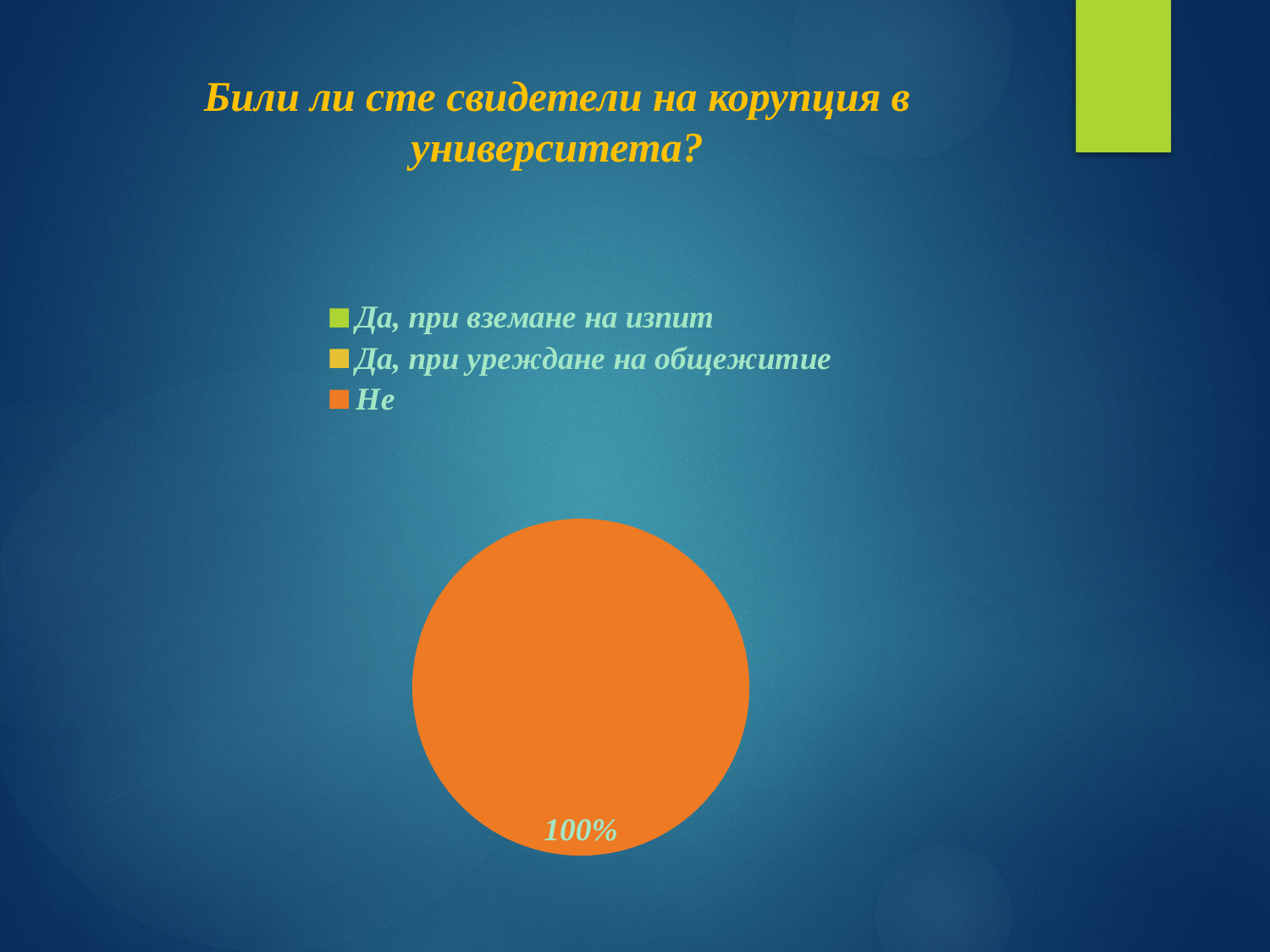
Is the share for "Не" greater or less than 50%? greater What colour is the "Не" slice of the pie? orange What kind of chart is shown on the slide? pie chart How many entries does the legend list? 3 What is the title of the chart? Били ли сте свидетели на корупция в университета? Which is larger, the share for "Не" or the share for "Да, при вземане на изпит"? Не What share of the pie does the "Не" slice take? 100% Which category has the largest share of the pie? Не How many slices are visible in the pie? 1